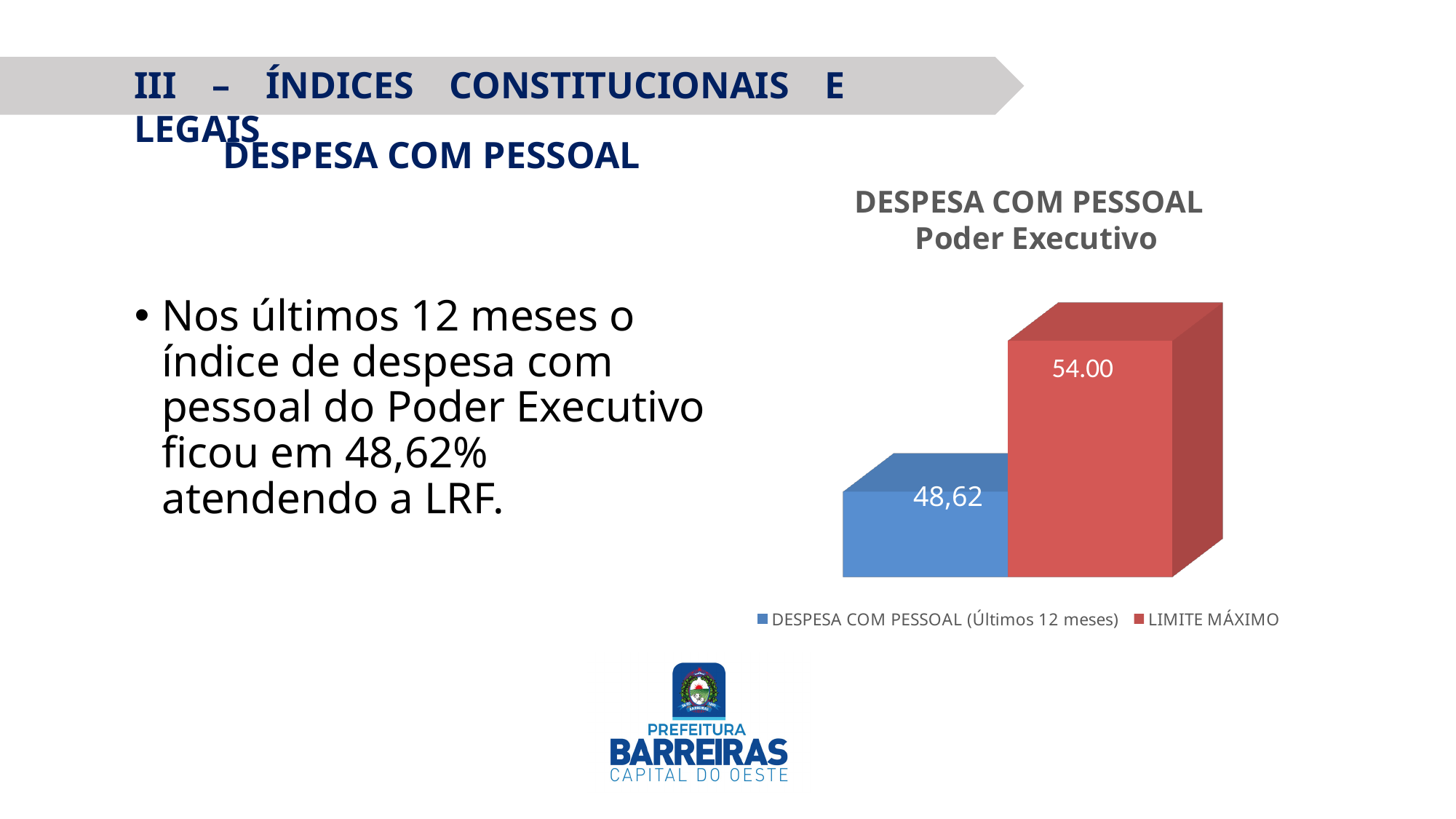
What colour is the bar for LIMITE MÁXIMO? red What kind of chart is shown on the slide? bar chart How many series does the chart legend list? 2 Which series has the higher value in the chart? LIMITE MÁXIMO What is the title of the chart? DESPESA COM PESSOAL Poder Executivo What is the difference between the LIMITE MÁXIMO value and the DESPESA COM PESSOAL (Últimos 12 meses) value? 5.38 What is the value for LIMITE MÁXIMO in the chart? 54.00 How many bars are plotted in the chart? 2 What is the value for DESPESA COM PESSOAL (Últimos 12 meses) in the chart? 48,62 Is the value for DESPESA COM PESSOAL (Últimos 12 meses) larger or smaller than the value for LIMITE MÁXIMO? smaller Which series has the lower value in the chart? DESPESA COM PESSOAL (Últimos 12 meses)